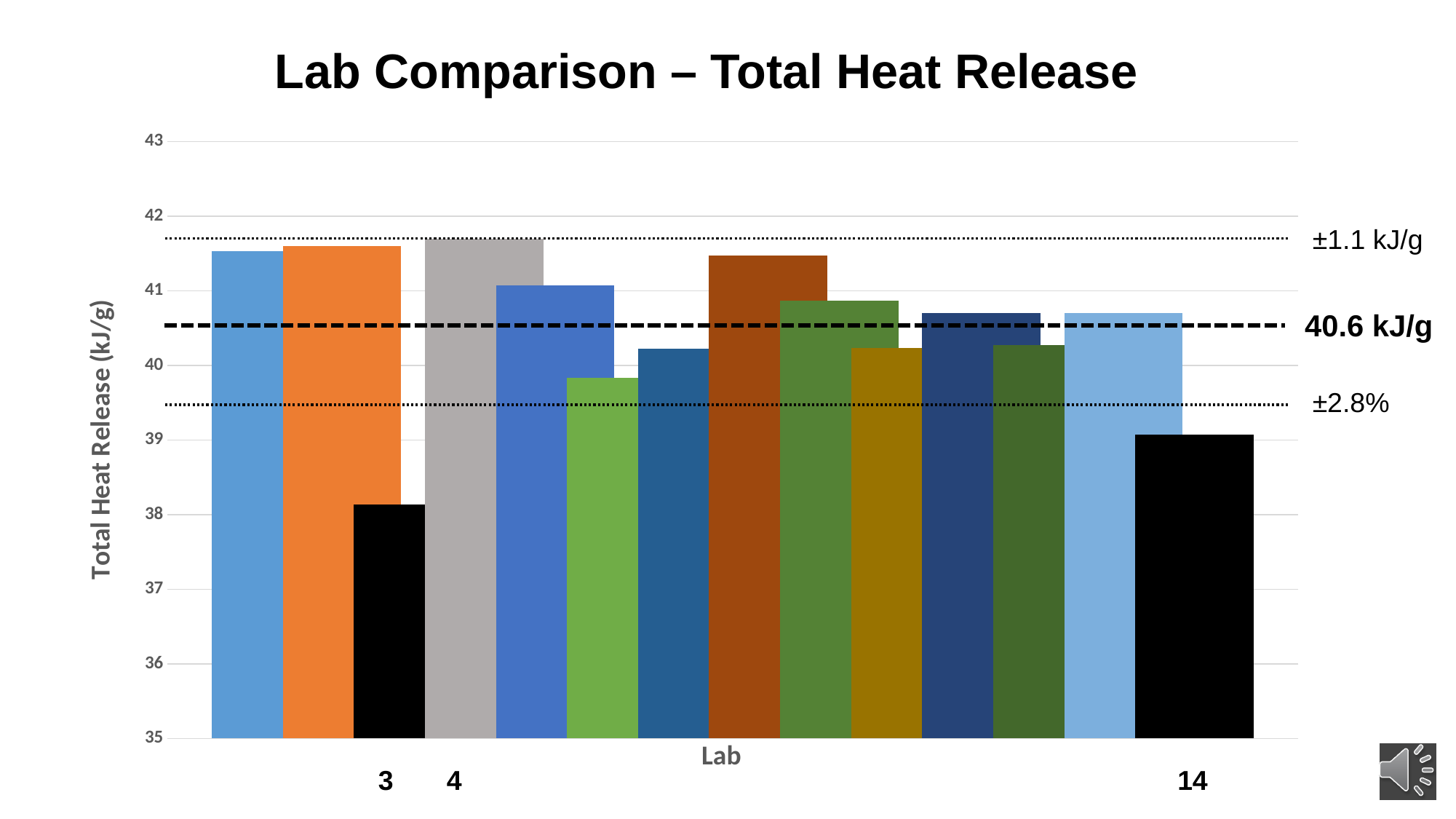
Is the value for Lab 14 greater or less than 40? less Which has the higher total heat release, Lab 3 or Lab 4? Lab 4 What kind of chart is shown on the slide? bar chart What is the label of the y axis? Total Heat Release (kJ/g) Is the value for Lab 14 greater or less than 38? greater Is the value for Lab 3 greater or less than 39? less Which has the higher total heat release, Lab 3 or Lab 14? Lab 14 What is the title of the chart? Lab Comparison – Total Heat Release Which lab has the lowest total heat release? Lab 3 What value is marked by the bold dashed horizontal reference line? 40.6 kJ/g How many bars (labs) are plotted in the chart? 14